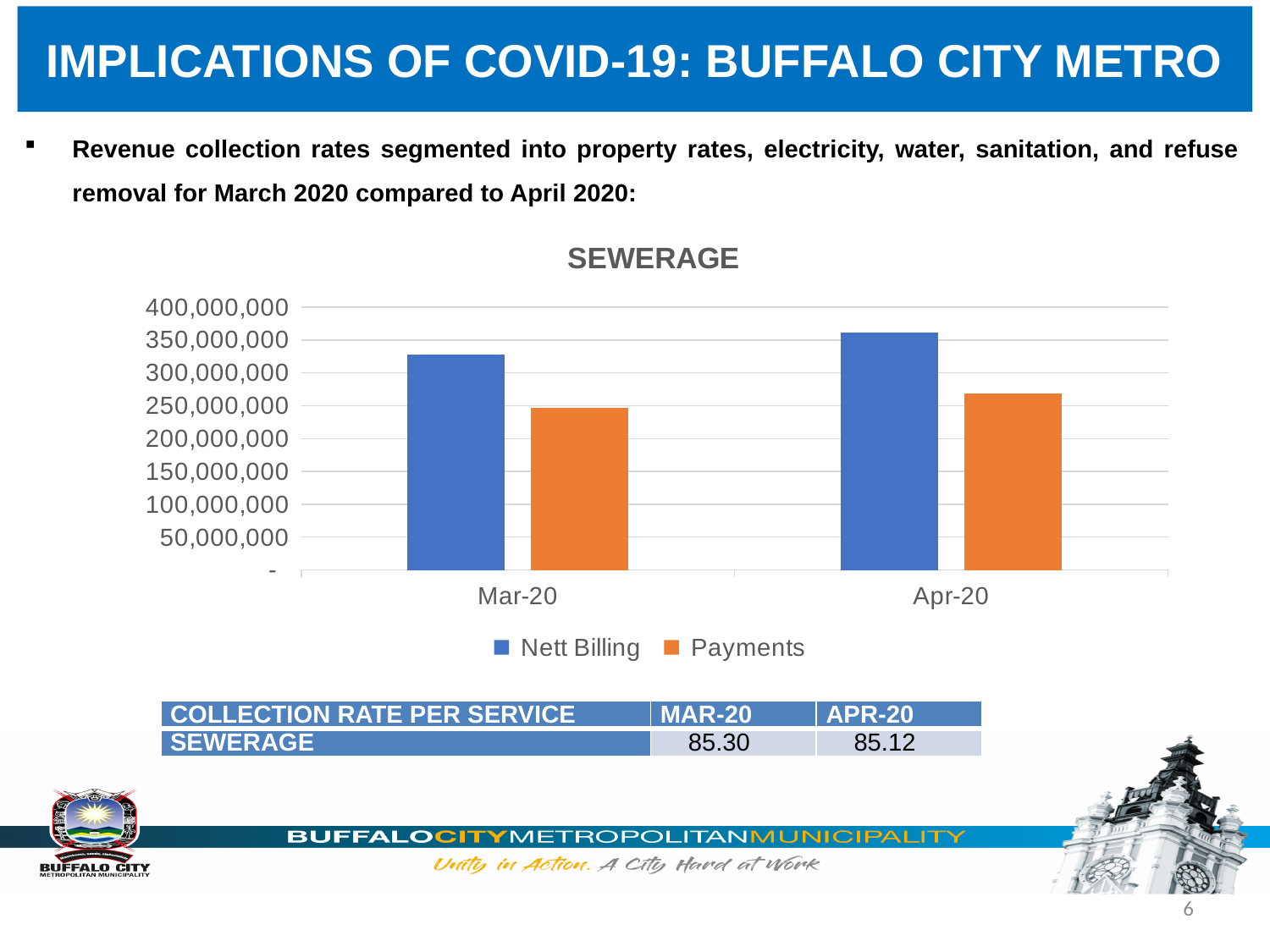
Which colour represents Payments in the chart? Orange Is the Payments value for Apr-20 greater or less than 250,000,000? greater Is the Payments value for Mar-20 greater or less than 300,000,000? less Is the Nett Billing value for Apr-20 greater or less than 300,000,000? greater Do the Payments values rise or fall from Mar-20 to Apr-20? Rise How many categories are shown on the x axis of the chart? 2 Which month has the lowest Payments value? Mar-20 Which month has the higher Nett Billing value, Mar-20 or Apr-20? Apr-20 What type of chart is shown on the slide? Bar chart What is the title of the chart? SEWERAGE How many series does the chart legend list? 2